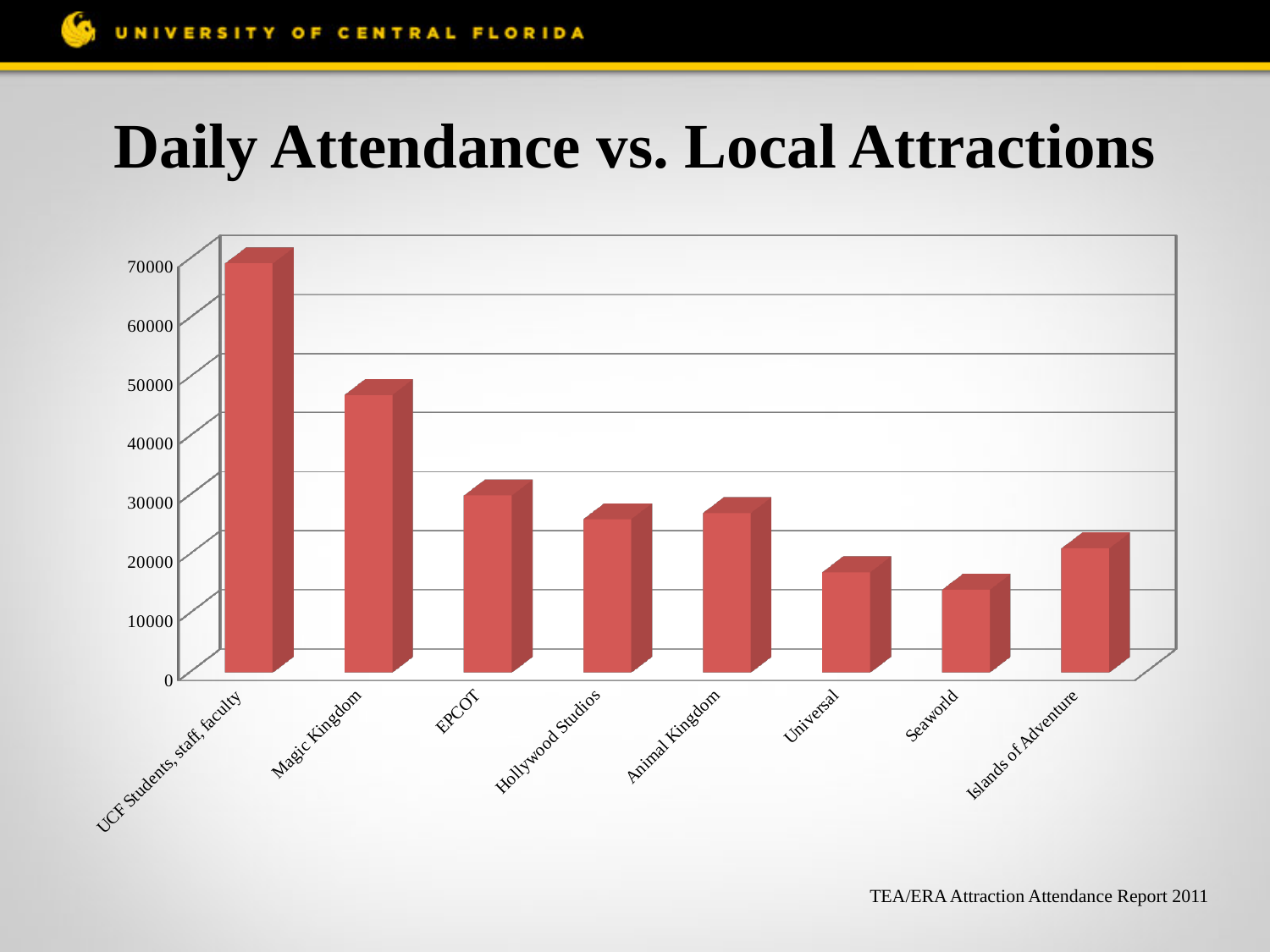
Which is larger, the value for Magic Kingdom or the value for EPCOT? Magic Kingdom What kind of chart is shown on the slide? bar chart Is the value for Islands of Adventure greater or less than 30000? less Which is larger, the value for Universal or the value for Islands of Adventure? Islands of Adventure Which category has the lowest value in the chart? Seaworld Is the value for Hollywood Studios greater or less than 30000? less Is the value for Universal greater or less than 20000? less Which category has the highest value in the chart? UCF Students, staff, faculty How many categories are plotted in the chart? 8 What is the title of the chart on the slide? Daily Attendance vs. Local Attractions